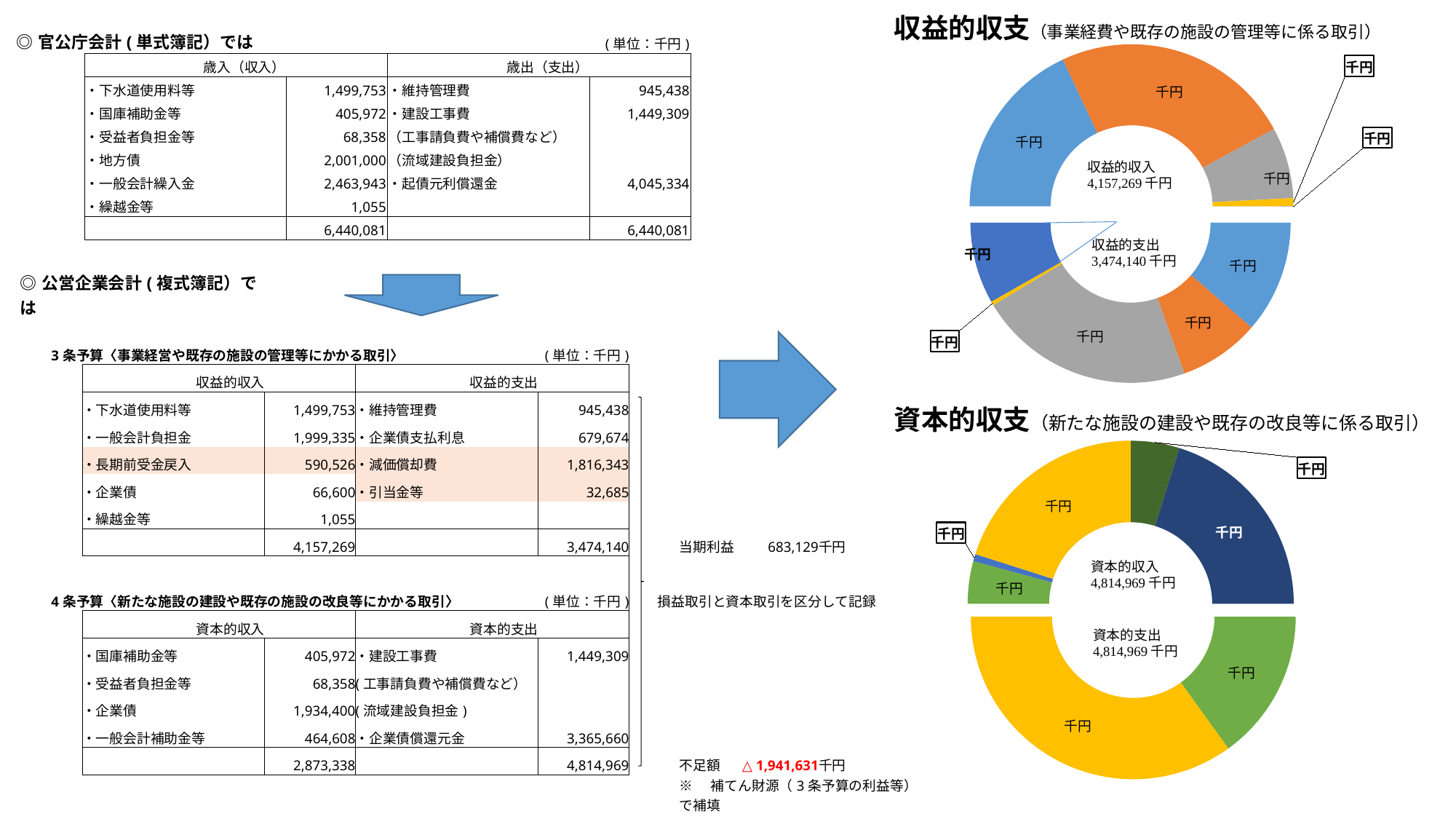
What is the title of the doughnut chart at the top right of the slide? 収益的収支 What kind of chart is the 収益的収支 chart at the top right of the slide? doughnut chart In the 収益的収支 chart, what total is shown for 収益的支出 in the centre of the doughnut? 3,474,140 千円 In the 収益的収支 chart, which is larger, the 収益的収入 total or the 収益的支出 total? 収益的収入 In the 収益的収支 chart, what is the difference between the 収益的収入 total and the 収益的支出 total? 683,129 千円 In the 資本的収支 chart, is the 資本的収入 total larger than, smaller than, or equal to the 資本的支出 total? equal In the 収益的収支 chart, what total is shown for 収益的収入 in the centre of the doughnut? 4,157,269 千円 In the 資本的収支 chart, what total is shown for 資本的支出 in the centre of the doughnut? 4,814,969 千円 What is the title of the doughnut chart at the bottom right of the slide? 資本的収支 In the 資本的収支 chart, what total is shown for 資本的収入 in the centre of the doughnut? 4,814,969 千円 What kind of chart is the 資本的収支 chart at the bottom right of the slide? doughnut chart